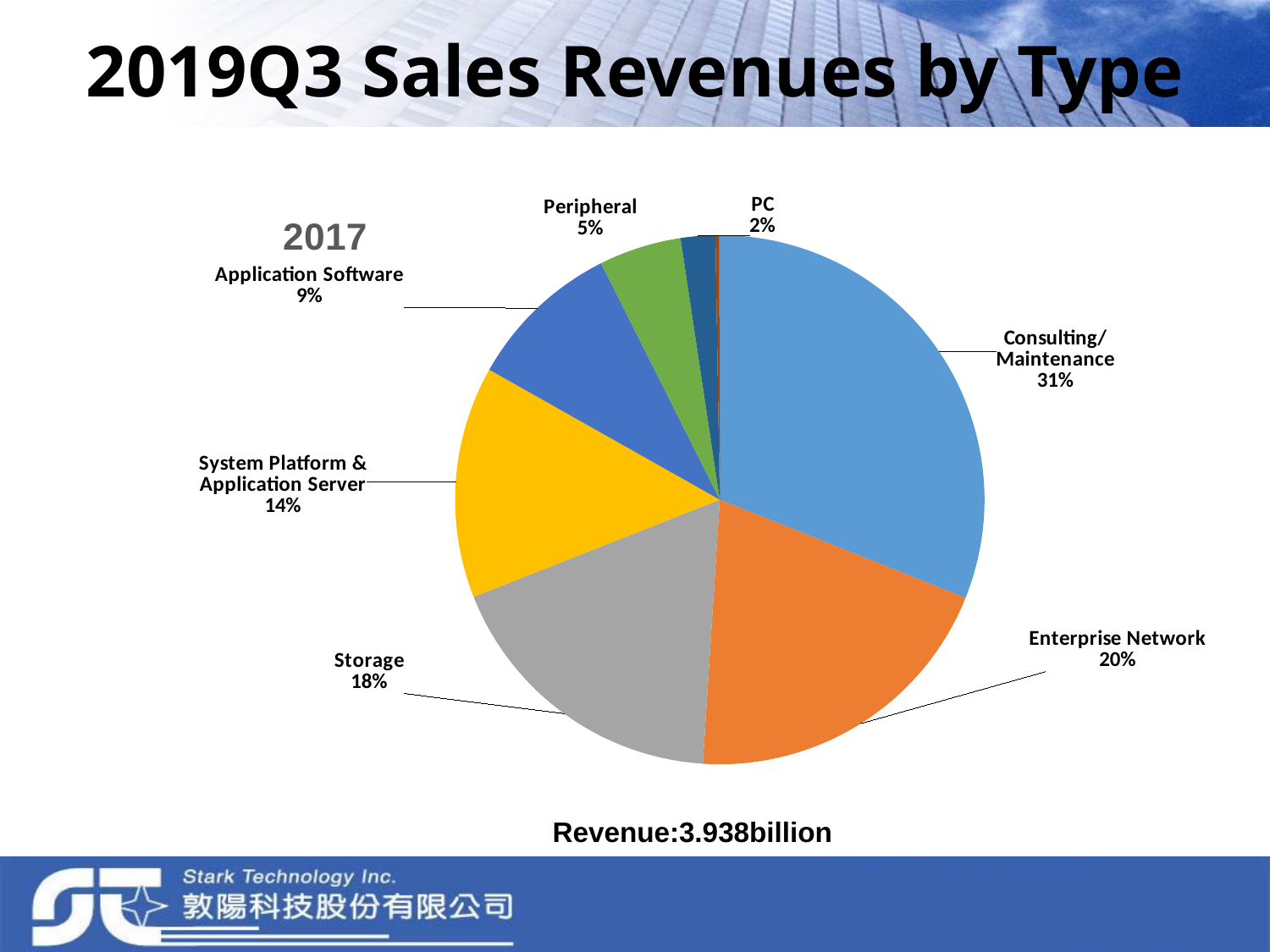
What kind of chart is shown on the slide? pie chart Which category has the largest share of the pie? Consulting/Maintenance What percentage is shown for System Platform & Application Server? 14% What share does Application Software have? 9% What percentage is labelled for PC? 2% What total revenue figure is printed below the chart? Revenue:3.938billion Which is larger, the share for Storage or the share for Peripheral? Storage What is the difference in percentage points between Consulting/Maintenance and Enterprise Network? 11 Which labelled category has the smallest share of the pie? PC